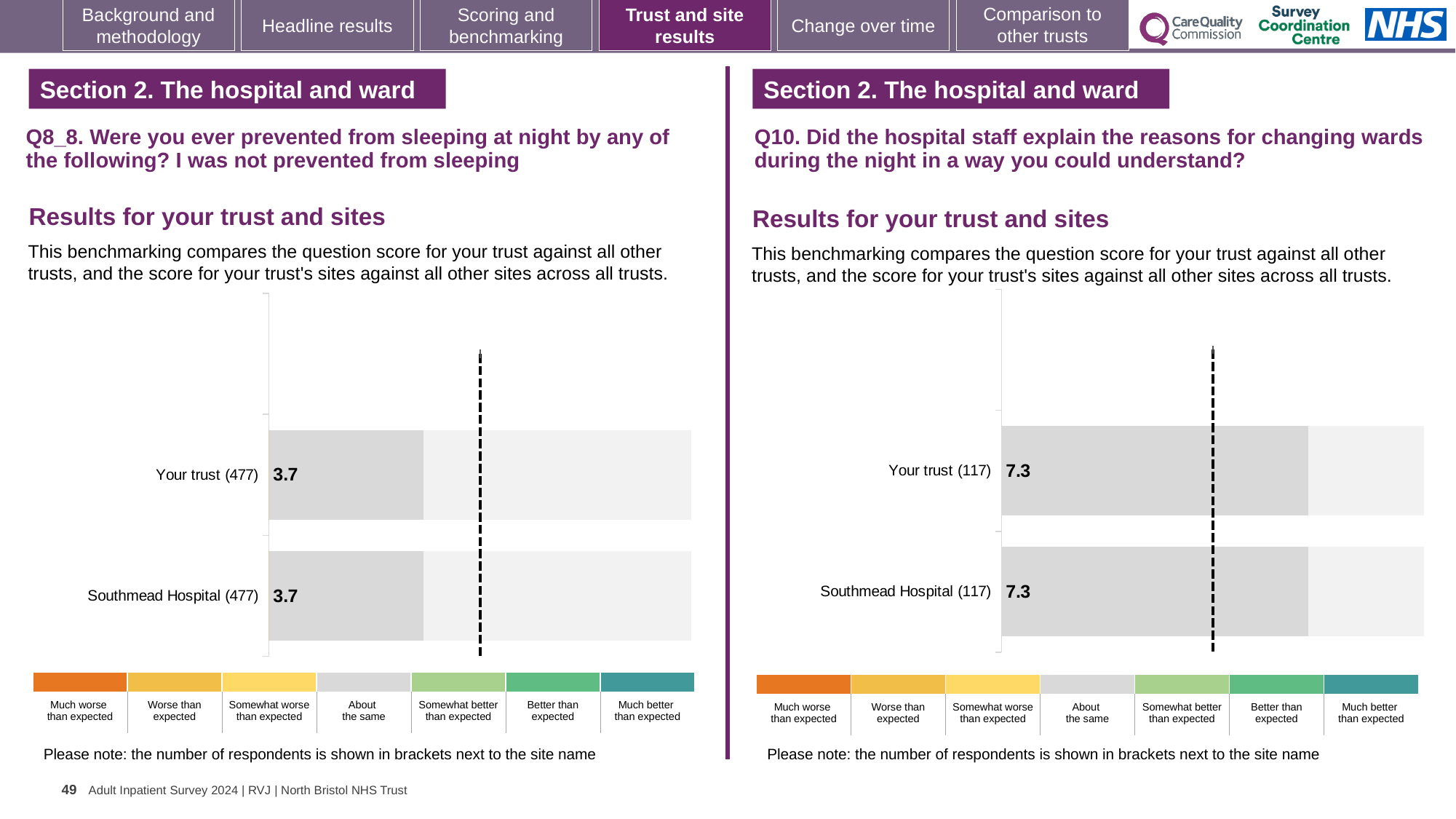
On the left chart (Q8_8), what is the score for Your trust? 3.7 On the left chart (Q8_8), how many respondents are shown in brackets next to Your trust? 477 On the right chart (Q10), what is the difference between the score for Your trust and the score for Southmead Hospital? 0 On the right chart (Q10), what is the score for Southmead Hospital? 7.3 On the left chart (Q8_8), how many bars are plotted? 2 What kind of chart is the left chart (Q8_8)? bar chart On the right chart (Q10), how many bars are plotted? 2 On the left chart (Q8_8), what is the score for Southmead Hospital? 3.7 On the left chart (Q8_8), what is the difference between the score for Your trust and the score for Southmead Hospital? 0 What kind of chart is the right chart (Q10)? bar chart On the right chart (Q10), what is the score for Your trust? 7.3 On the right chart (Q10), how many respondents are shown in brackets next to Southmead Hospital? 117